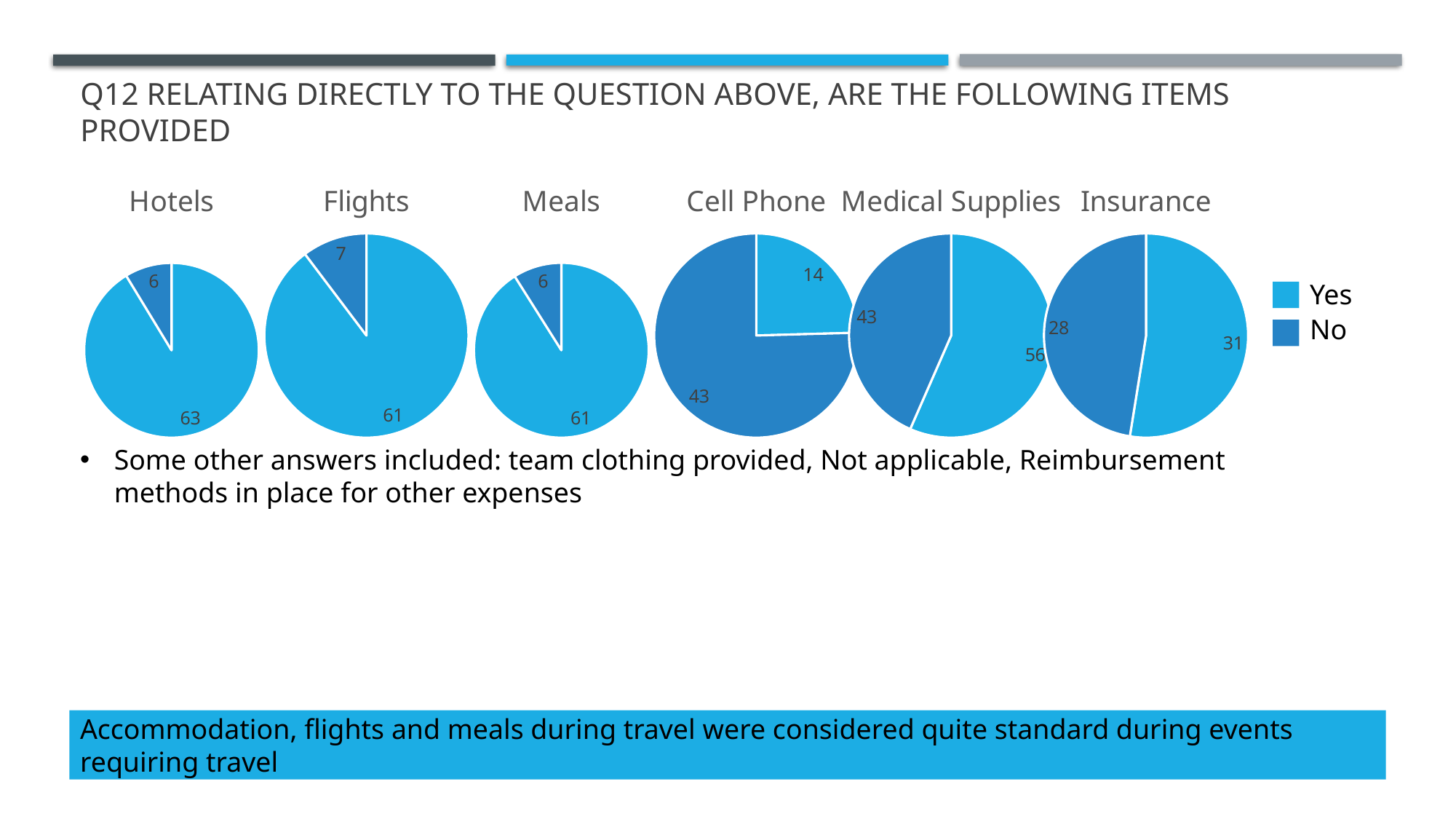
In the Hotels pie chart, what is the value for Yes? 63 In the Flights pie chart, what is the value for No? 7 In the Cell Phone pie chart, what is the total of the Yes and No values? 57 In the Hotels pie chart, what is the difference between the Yes and No values? 57 In the Hotels pie chart, what is the value for No? 6 How many pie charts are on the slide? 6 Which legend entry is shown in the darker blue colour? No In the Cell Phone pie chart, what is the value for Yes? 14 What kind of charts are shown on the slide? Pie charts In the Meals pie chart, what is the value for Yes? 61 In the Cell Phone pie chart, which is larger, Yes or No? No How many series does the legend list? 2